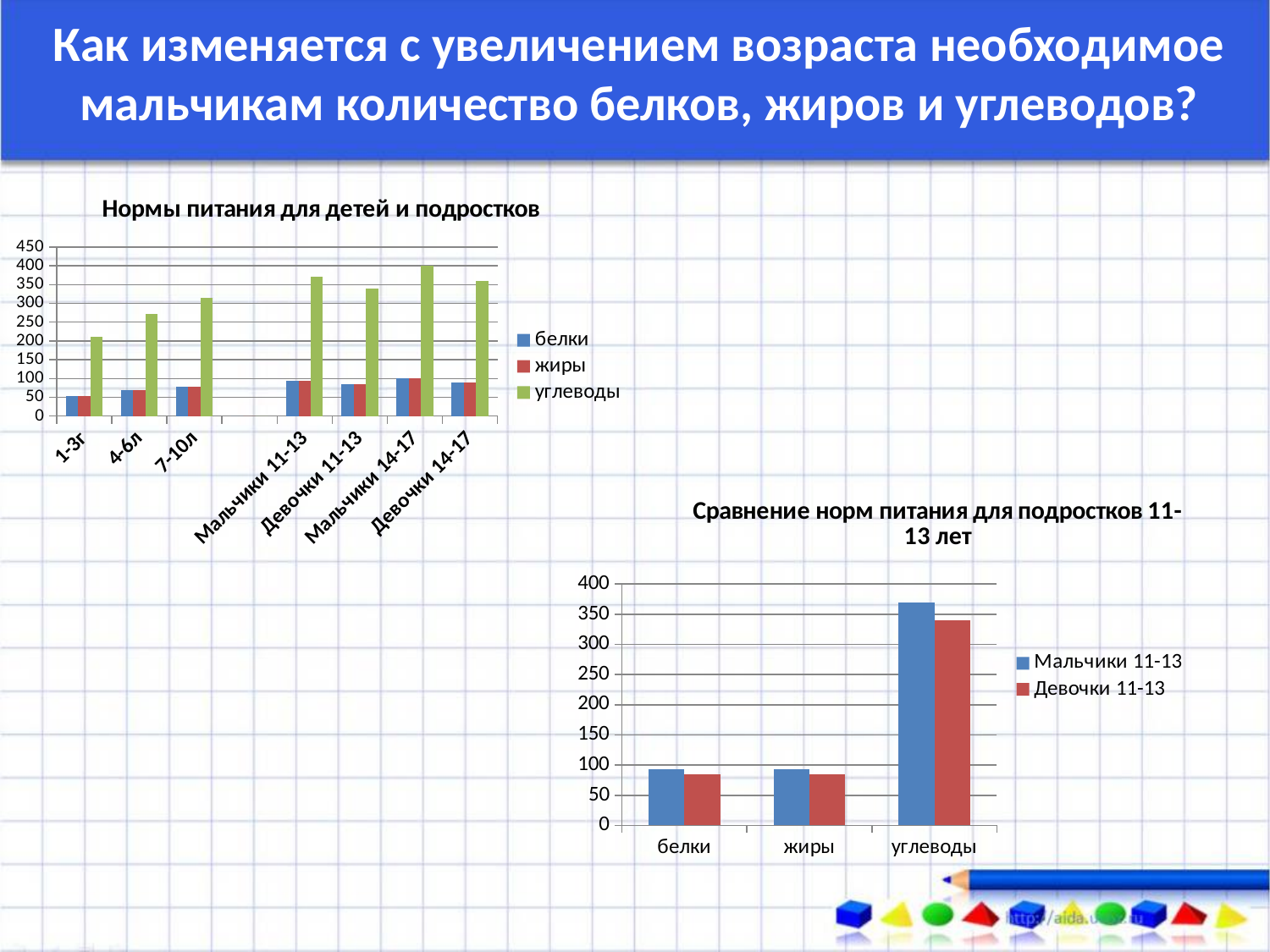
How many series does the legend of the chart "Сравнение норм питания для подростков 11-13 лет" list? 2 How many series does the legend of the chart "Нормы питания для детей и подростков" list? 3 In the chart "Нормы питания для детей и подростков", which category has the highest углеводы value? Мальчики 14-17 In the chart "Нормы питания для детей и подростков", is the углеводы value for Мальчики 14-17 greater or less than 350? greater In the chart "Нормы питания для детей и подростков", which category has the lowest углеводы value? 1-3г In the chart "Нормы питания для детей и подростков", is the углеводы value for 1-3г greater or less than 250? less How many categories are shown on the x axis of the chart "Нормы питания для детей и подростков"? 7 In the chart "Сравнение норм питания для подростков 11-13 лет", is the углеводы value for Мальчики 11-13 greater or less than 350? greater In the chart "Сравнение норм питания для подростков 11-13 лет", which is larger for углеводы: Мальчики 11-13 or Девочки 11-13? Мальчики 11-13 In the chart "Сравнение норм питания для подростков 11-13 лет", which category has the highest values? углеводы What kind of chart is the chart titled "Нормы питания для детей и подростков"? bar chart In the chart "Нормы питания для детей и подростков", which series is shown in green? углеводы